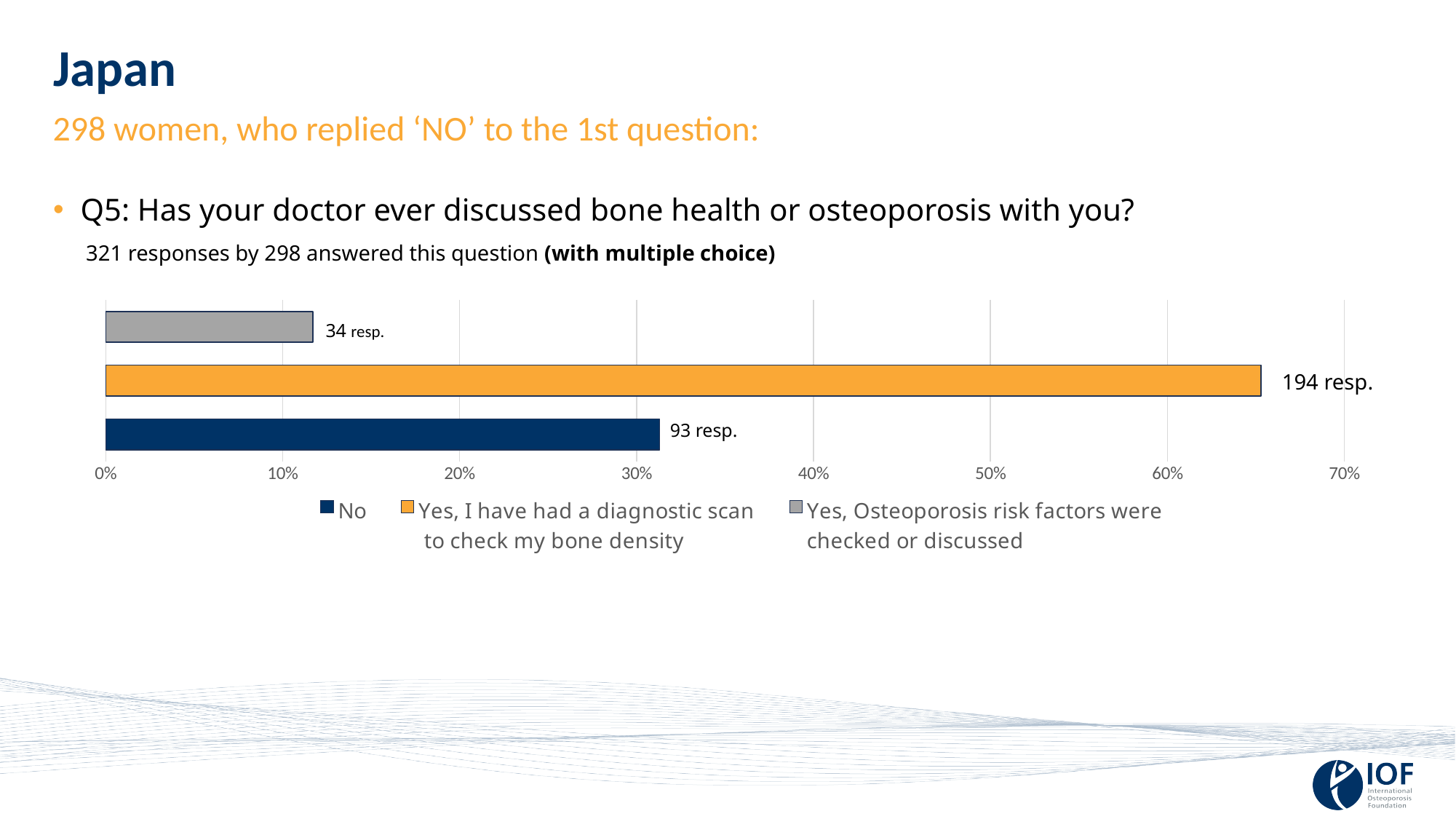
Which has more responses: 'No' or 'Yes, Osteoporosis risk factors were checked or discussed'? No What is the data label on the bar for 'Yes, I have had a diagnostic scan to check my bone density'? 194 resp. What is the data label on the bar for 'No'? 93 resp. Is the percentage for 'Yes, I have had a diagnostic scan to check my bone density' greater or less than 60%? greater Is the percentage for 'No' greater or less than 40%? less What kind of chart is shown on the slide? bar chart How many series does the legend list? 3 Which response option has the highest number of responses? Yes, I have had a diagnostic scan to check my bone density What is the data label on the bar for 'Yes, Osteoporosis risk factors were checked or discussed'? 34 resp. How many more responses does 'No' have than 'Yes, Osteoporosis risk factors were checked or discussed'? 59 Which response option has the lowest number of responses? Yes, Osteoporosis risk factors were checked or discussed How many more responses does 'Yes, I have had a diagnostic scan to check my bone density' have than 'No'? 101